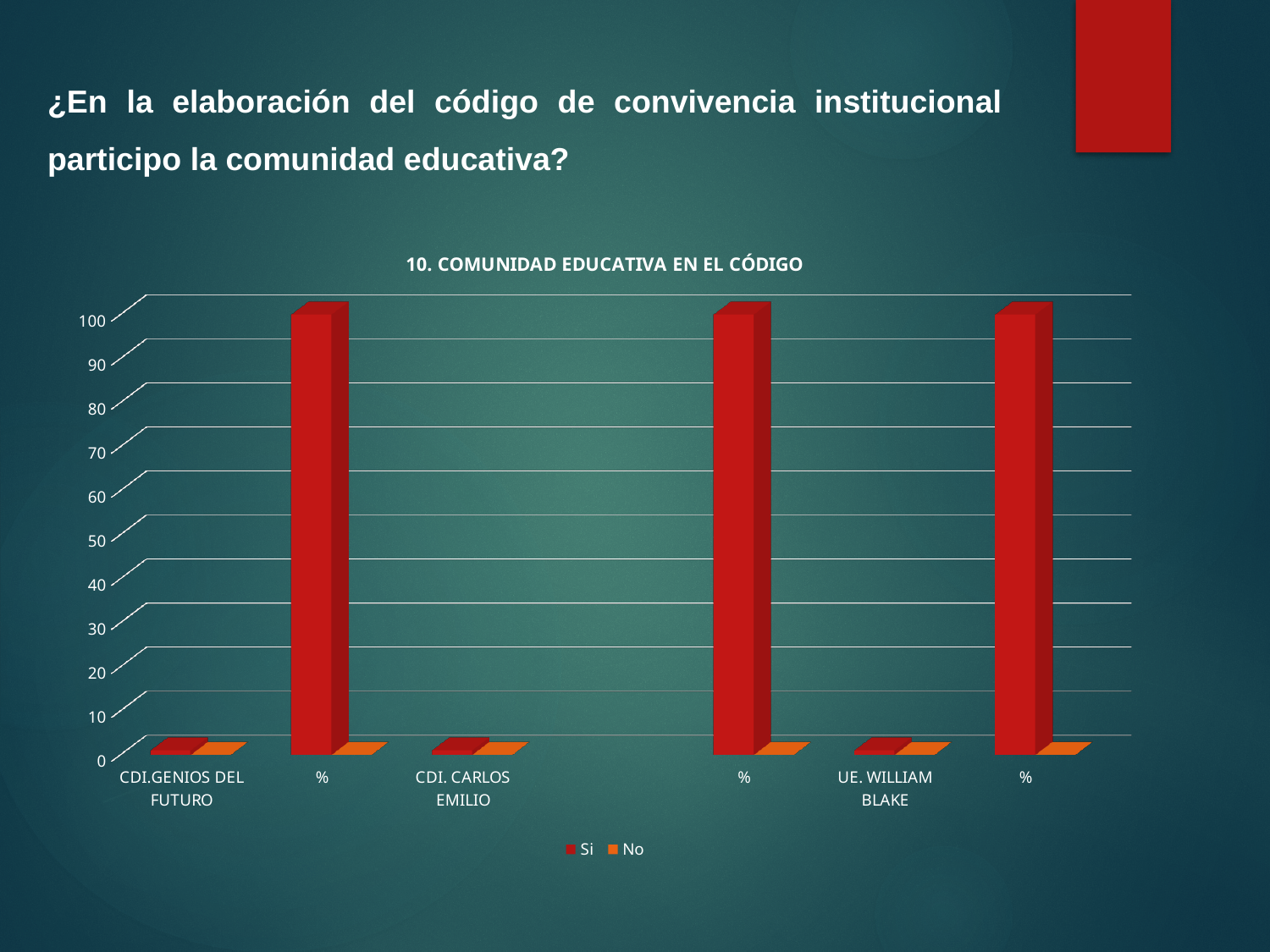
At the "%" category after CDI. CARLOS EMILIO, which series has the larger value, Si or No? Si Is the Si value for CDI.GENIOS DEL FUTURO greater or less than 10? less Is the No value for CDI. CARLOS EMILIO greater or less than 10? less Is the Si value at the first "%" category (after CDI.GENIOS DEL FUTURO) greater or less than 90? greater What is the title of the chart? 10. COMUNIDAD EDUCATIVA EN EL CÓDIGO What kind of chart is shown on the slide? bar chart How many series does the chart legend list? 2 Which series has the larger value at the "%" category after UE. WILLIAM BLAKE, Si or No? Si What are the two series named in the legend? Si and No How many tall red bars reach near the top of the chart? 3 Which series is the lowest at the "%" category after CDI.GENIOS DEL FUTURO? No